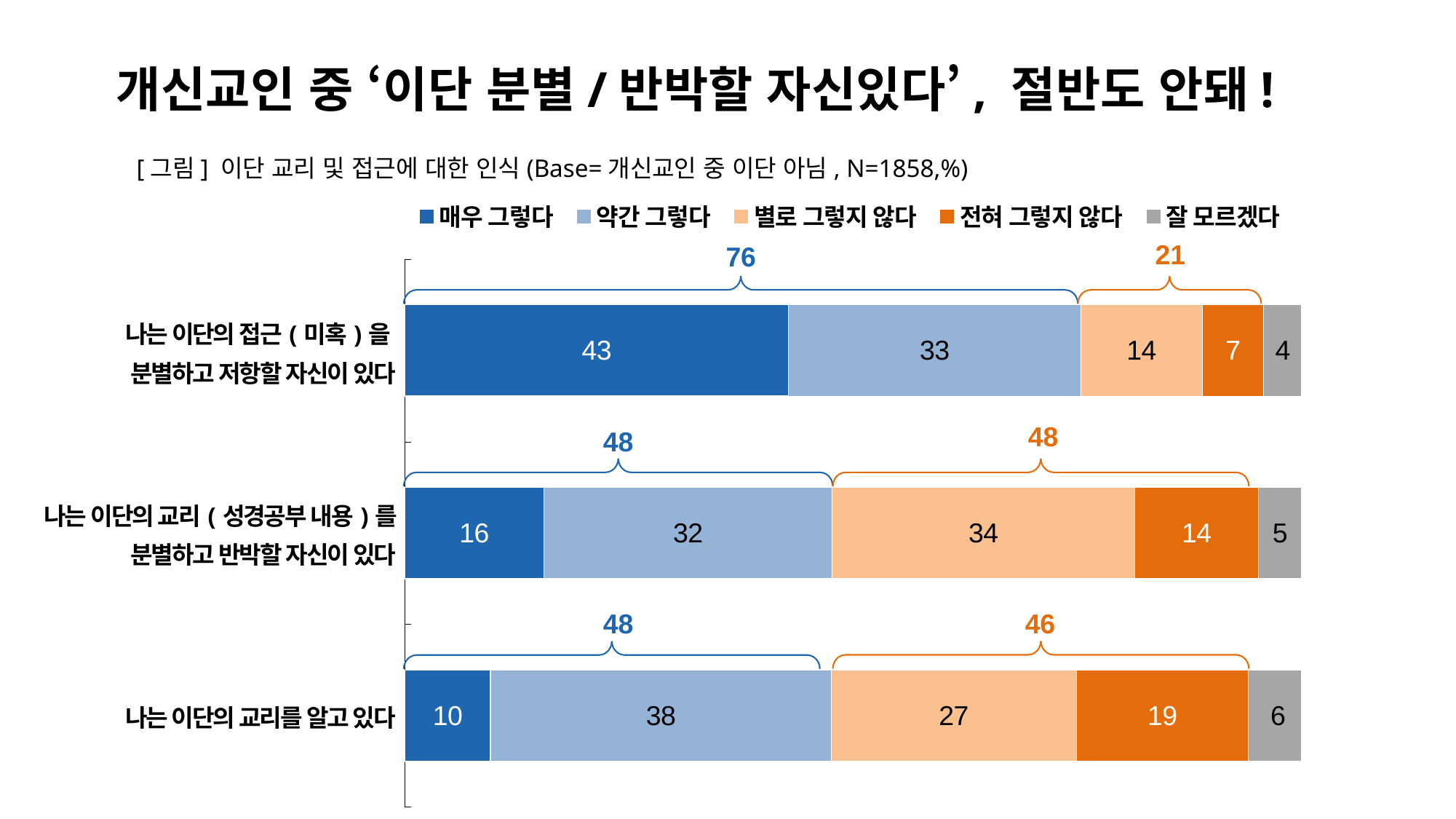
What is the combined value shown by the blue bracket above the bar for '나는 이단의 접근(미혹)을 분별하고 저항할 자신이 있다'? 76 How many series does the legend list? 5 What is the difference between the '약간 그렇다' values for '나는 이단의 교리를 알고 있다' and '나는 이단의 접근(미혹)을 분별하고 저항할 자신이 있다'? 5 What is the total of the stacked bar for '나는 이단의 교리를 알고 있다'? 100 What kind of chart is shown on the slide? Stacked bar chart Which statement has the highest '매우 그렇다' value? 나는 이단의 접근(미혹)을 분별하고 저항할 자신이 있다 How many categories (statements) are plotted in the chart? 3 What is the value of '별로 그렇지 않다' for '나는 이단의 교리(성경공부 내용)를 분별하고 반박할 자신이 있다'? 34 Which statement has the lowest '매우 그렇다' value? 나는 이단의 교리를 알고 있다 Which is larger: the '잘 모르겠다' value for '나는 이단의 교리를 알고 있다' or for '나는 이단의 접근(미혹)을 분별하고 저항할 자신이 있다'? 나는 이단의 교리를 알고 있다 What is the value of '전혀 그렇지 않다' for '나는 이단의 교리를 알고 있다'? 19 What is the value of '매우 그렇다' for '나는 이단의 접근(미혹)을 분별하고 저항할 자신이 있다'? 43